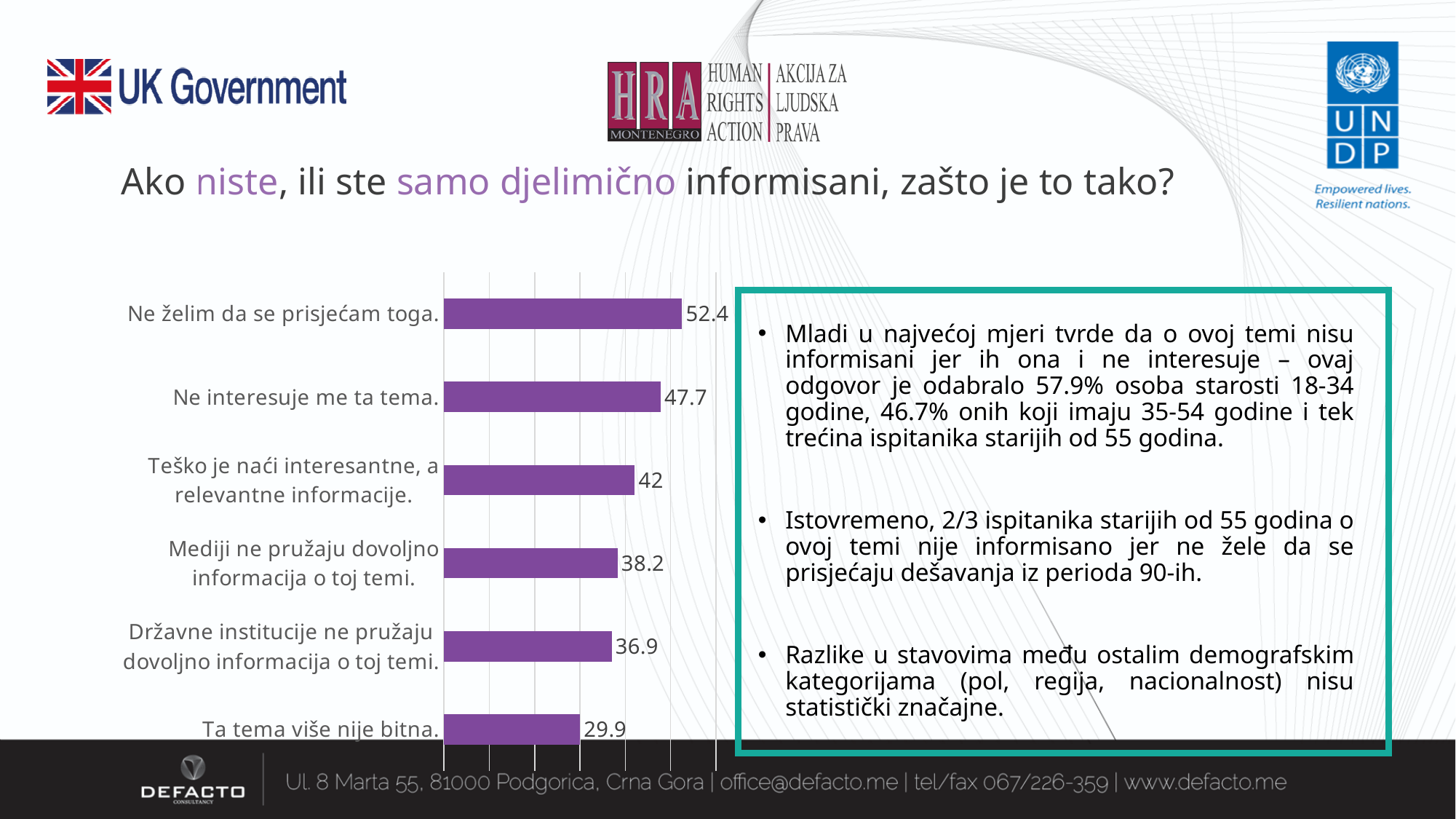
Which category has the lowest value? Ta tema više nije bitna. Which is larger: the value for "Mediji ne pružaju dovoljno informacija o toj temi." or "Državne institucije ne pružaju dovoljno informacija o toj temi."? Mediji ne pružaju dovoljno informacija o toj temi. What is the value for "Ne interesuje me ta tema."? 47.7 Which category has the highest value? Ne želim da se prisjećam toga. What is the value for "Ne želim da se prisjećam toga."? 52.4 What is the value for "Ta tema više nije bitna."? 29.9 What is the difference between the values for "Ne želim da se prisjećam toga." and "Ne interesuje me ta tema."? 4.7 What is the value for "Mediji ne pružaju dovoljno informacija o toj temi."? 38.2 What is the value for "Teško je naći interesantne, a relevantne informacije."? 42 What kind of chart is shown on the slide? Bar chart What colour are the bars in the chart? Purple How many categories are shown in the chart? 6